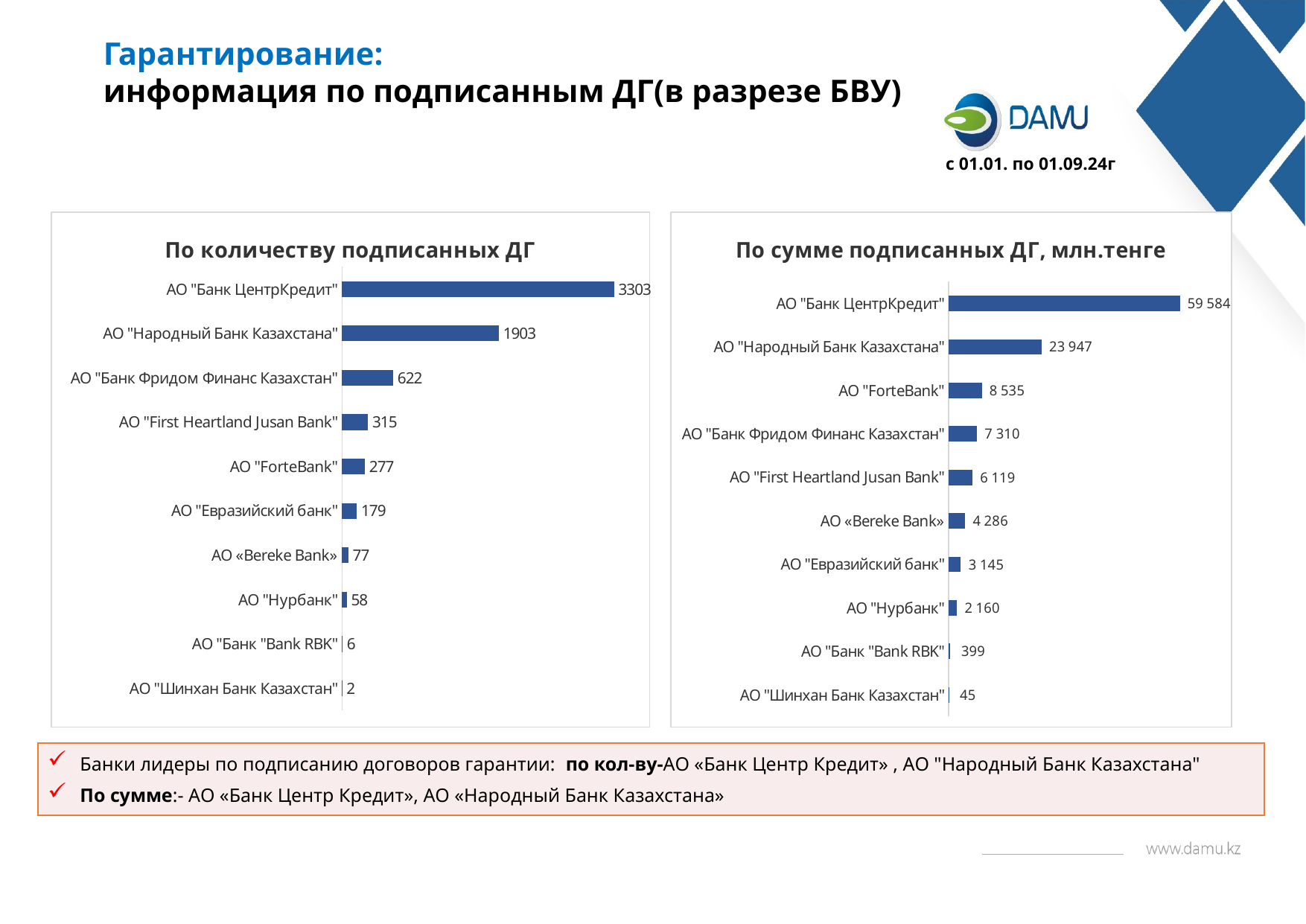
In the chart "По сумме подписанных ДГ, млн.тенге", which is larger: АО "Банк Фридом Финанс Казахстан" or АО "First Heartland Jusan Bank"? АО "Банк Фридом Финанс Казахстан" In the chart "По количеству подписанных ДГ", what is the value for АО "Bereke Bank"? 77 In the chart "По сумме подписанных ДГ, млн.тенге", which bank has the lowest value? АО "Шинхан Банк Казахстан" In the chart "По количеству подписанных ДГ", which bank has the highest value? АО "Банк ЦентрКредит" What type of chart is "По сумме подписанных ДГ, млн.тенге"? Bar chart How many banks are shown in the chart "По количеству подписанных ДГ"? 10 In the chart "По количеству подписанных ДГ", what is the difference between АО "Банк ЦентрКредит" and АО "Народный Банк Казахстана"? 1400 What period is stated on the slide for the data? с 01.01. по 01.09.24г In the chart "По сумме подписанных ДГ, млн.тенге", what is the value for АО "ForteBank"? 8 535 In the chart "По количеству подписанных ДГ", what is the value for АО "Народный Банк Казахстана"? 1903 In the chart "По сумме подписанных ДГ, млн.тенге", what is the difference between АО "Нурбанк" and АО "Банк "Bank RBK"? 1 761 In the chart "По количеству подписанных ДГ", which is larger: АО "ForteBank" or АО "Евразийский банк"? АО "ForteBank"